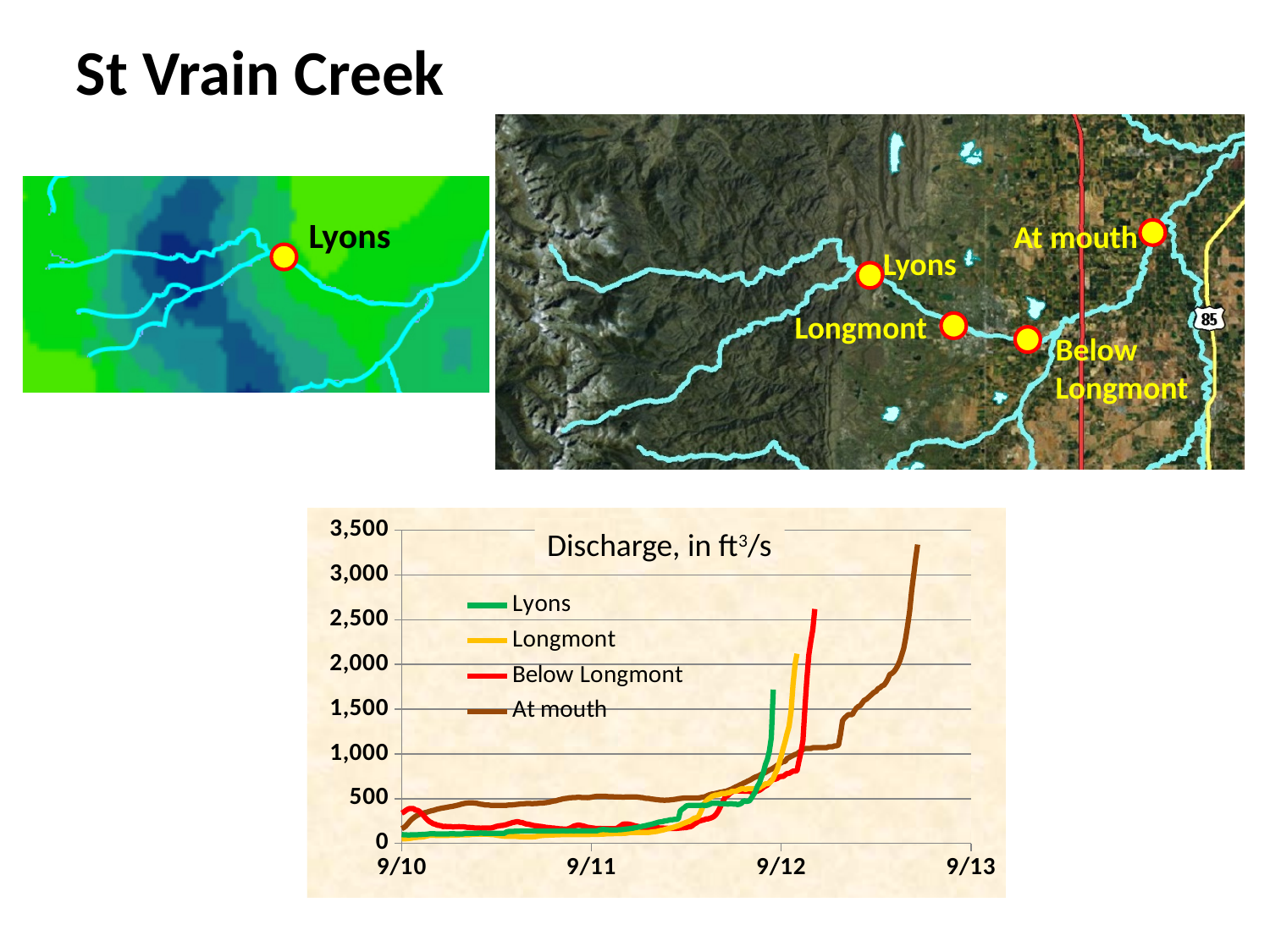
How many series does the chart legend list? 4 Is the peak value for Longmont greater or less than 2,000? greater Does the discharge for At mouth rise or fall from 9/12 to 9/13? rise What colour is the line for At mouth in the chart? brown Is the peak value for Lyons greater or less than 2,000? less Which series reaches the highest discharge value on the chart? At mouth Which series has the lowest peak discharge on the chart? Lyons Is the peak value for Below Longmont greater or less than 2,500? greater Which series has a higher peak discharge, Below Longmont or Longmont? Below Longmont What kind of chart is shown on the slide? line chart What is the title of the chart? Discharge, in ft³/s